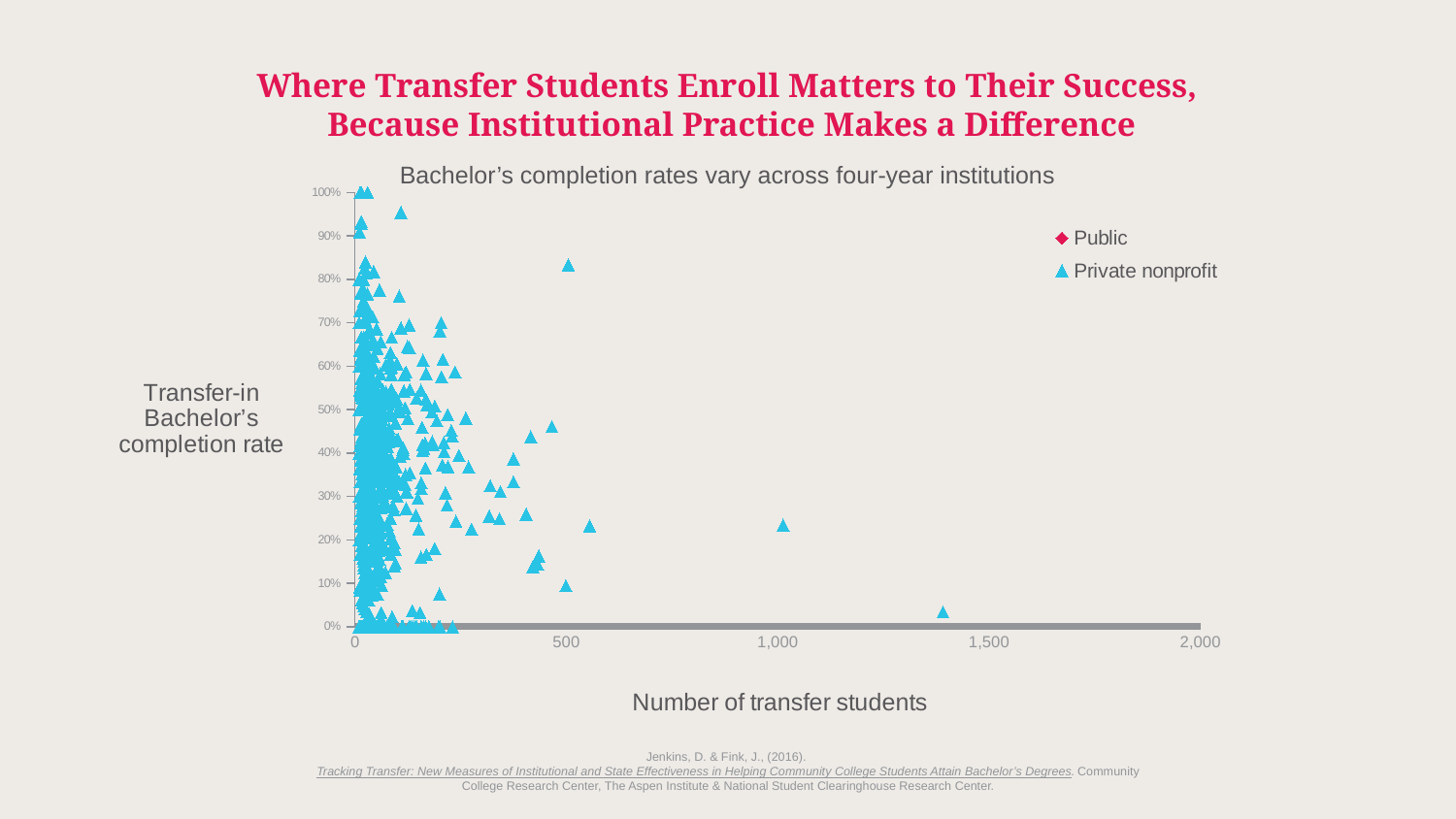
Is the completion rate for the point plotted near 1,000 transfer students greater or less than 30%? less What is the title of the chart? Bachelor's completion rates vary across four-year institutions What kind of chart is shown on the slide? Scatter chart What is the highest value shown on the y axis? 100% What are the two series named in the legend? Public and Private nonprofit How many series does the legend list? 2 Is the completion rate for the point plotted near 500 transfer students at the top of the cluster greater or less than 80%? greater Is the completion rate for the rightmost point greater or less than 10%? less Which series do the visible triangle markers belong to? Private nonprofit What is the highest value shown on the x axis? 2,000